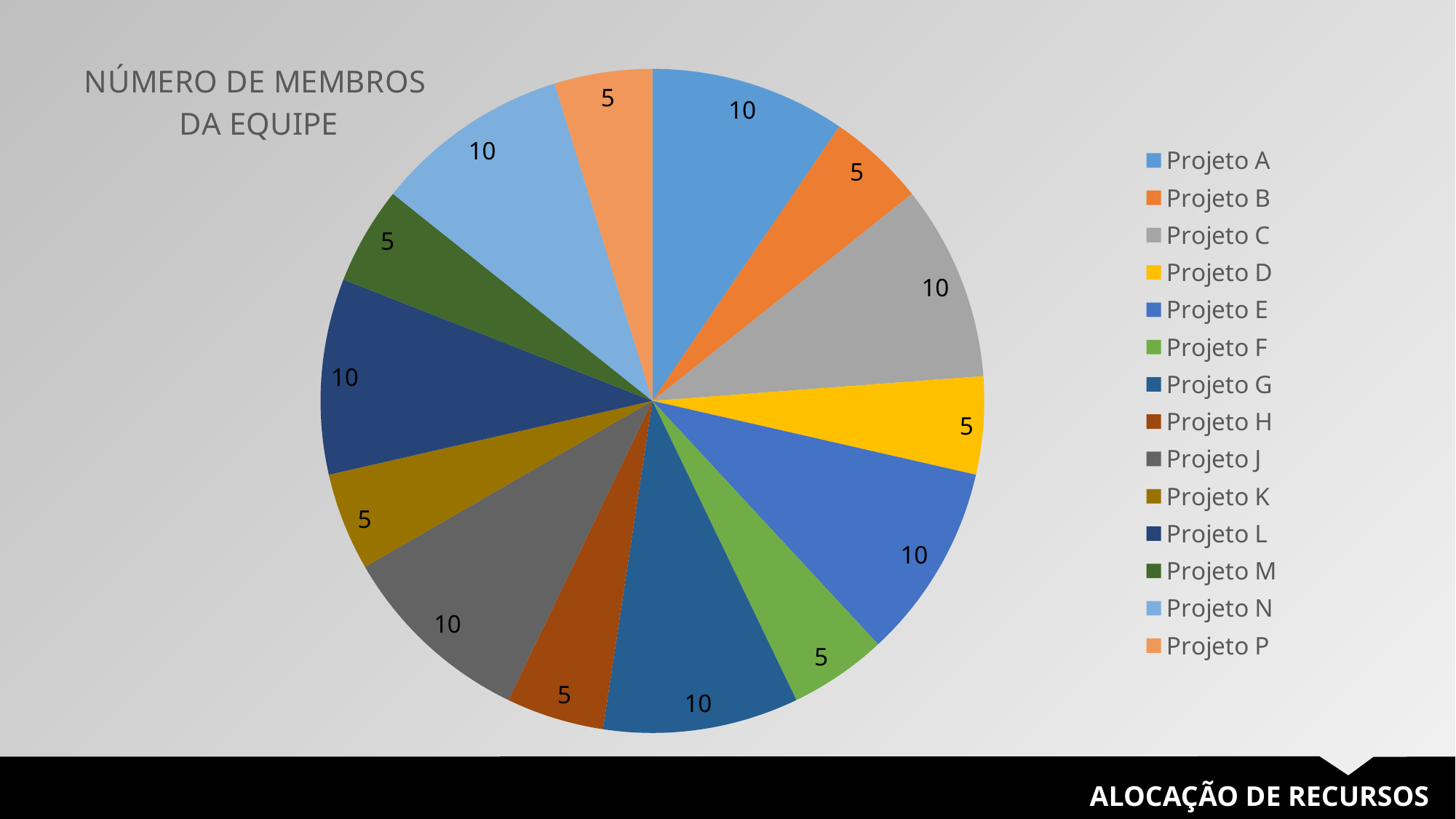
What is the title of the chart? NÚMERO DE MEMBROS DA EQUIPE Which is larger, the value for Projeto C or the value for Projeto B? Projeto C What kind of chart is shown on the slide? pie chart How many slices does the pie chart have? 14 What is the value for Projeto P? 5 What is the value for Projeto L? 10 What colour is the slice for Projeto D? yellow What is the value for Projeto D? 5 What is the difference between the value for Projeto G and the value for Projeto H? 5 How many slices have a value of 10? 7 How many entries does the legend list? 14 What is the value for Projeto A? 10